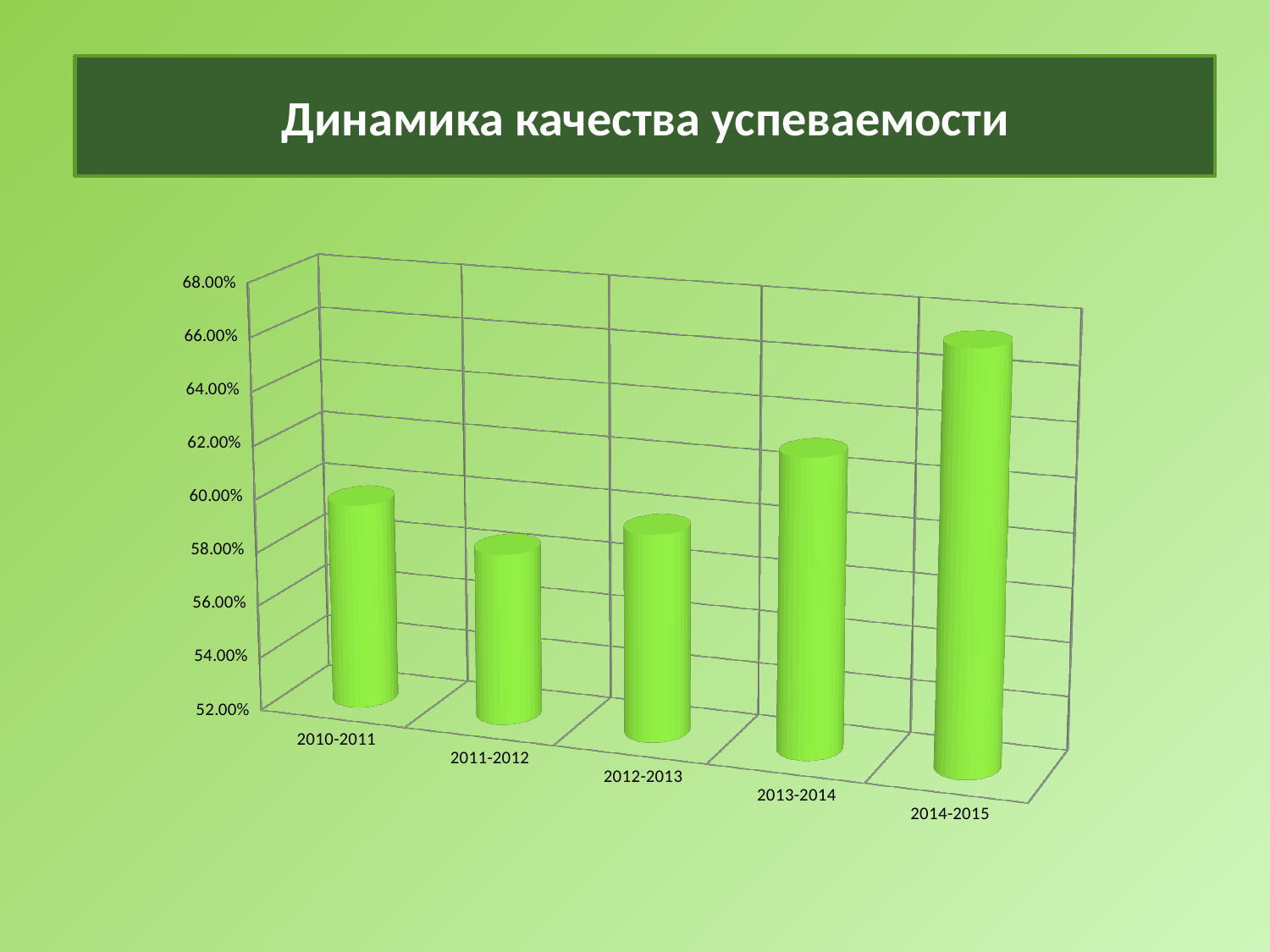
Is the value for 2014-2015 greater or less than 64.00%? greater Is the value for 2013-2014 greater or less than 60.00%? greater What type of chart is shown on the slide? bar chart Is the value for 2011-2012 greater or less than 60.00%? less Do the values rise or fall from 2012-2013 to 2014-2015? rise How many academic years are shown on the x axis? 5 Which academic year has the lowest value? 2011-2012 What colour are the bars in the chart? green Which is larger, the value for 2014-2015 or the value for 2010-2011? 2014-2015 What is the title of the chart? Динамика качества успеваемости Which academic year has the highest value? 2014-2015 Which is larger, the value for 2013-2014 or the value for 2012-2013? 2013-2014